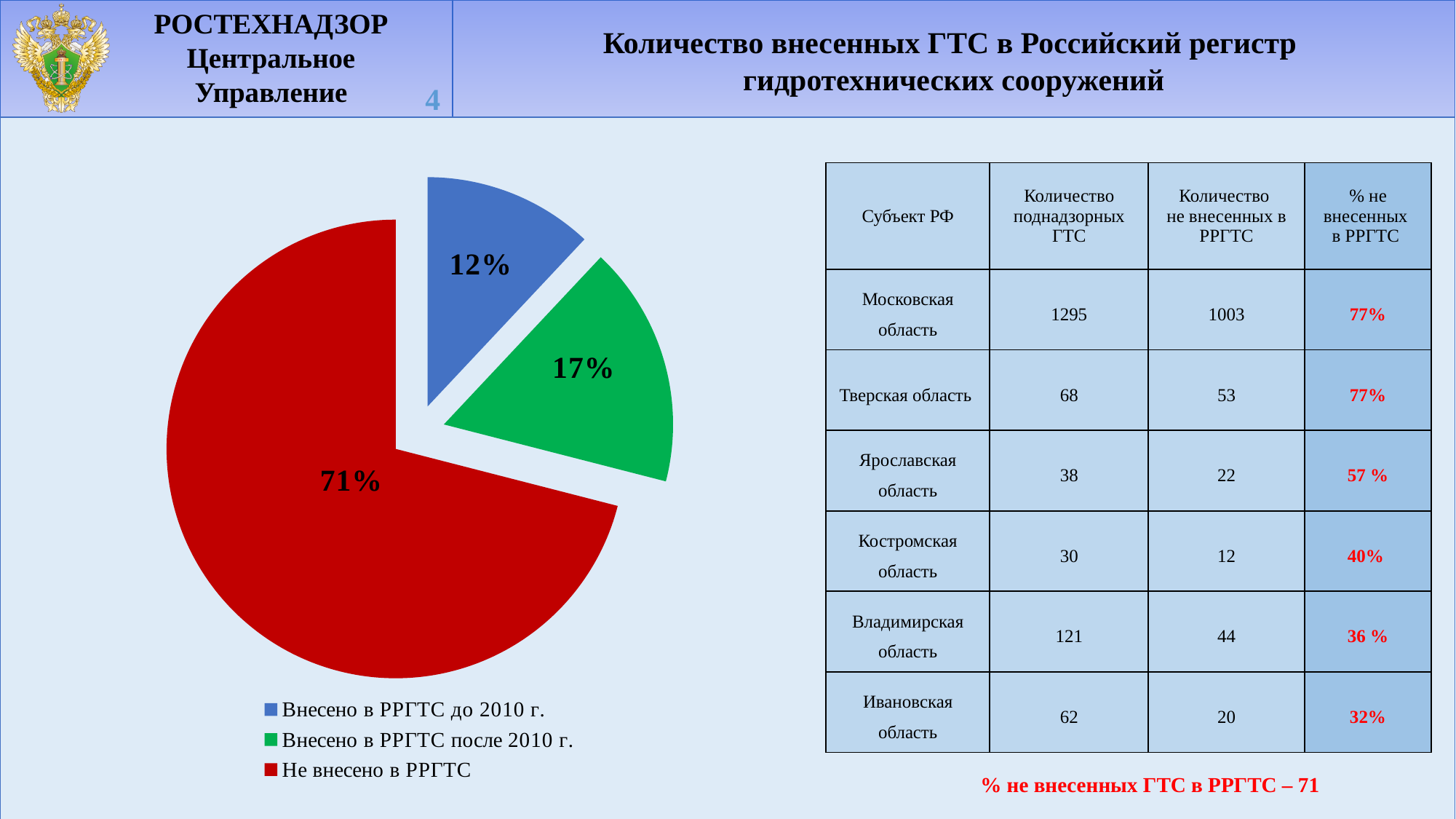
What share of the pie chart is labelled "Внесено в РРГТС до 2010 г."? 12% What kind of chart is shown on the slide? pie chart How many slices does the pie chart have? 3 Which slice is larger: "Внесено в РРГТС до 2010 г." or "Внесено в РРГТС после 2010 г."? Внесено в РРГТС после 2010 г. What share of the pie chart is labelled "Не внесено в РРГТС"? 71% What share of the pie chart is labelled "Внесено в РРГТС после 2010 г."? 17% Which category has the smallest slice in the pie chart? Внесено в РРГТС до 2010 г. What is the difference in percentage points between the "Не внесено в РРГТС" slice and the "Внесено в РРГТС после 2010 г." slice? 54 Which category has the largest slice in the pie chart? Не внесено в РРГТС How many entries does the pie chart legend list? 3 What is the combined share of the two "Внесено в РРГТС" slices (до 2010 г. and после 2010 г.)? 29% What colour is the slice labelled "Не внесено в РРГТС" in the pie chart? red